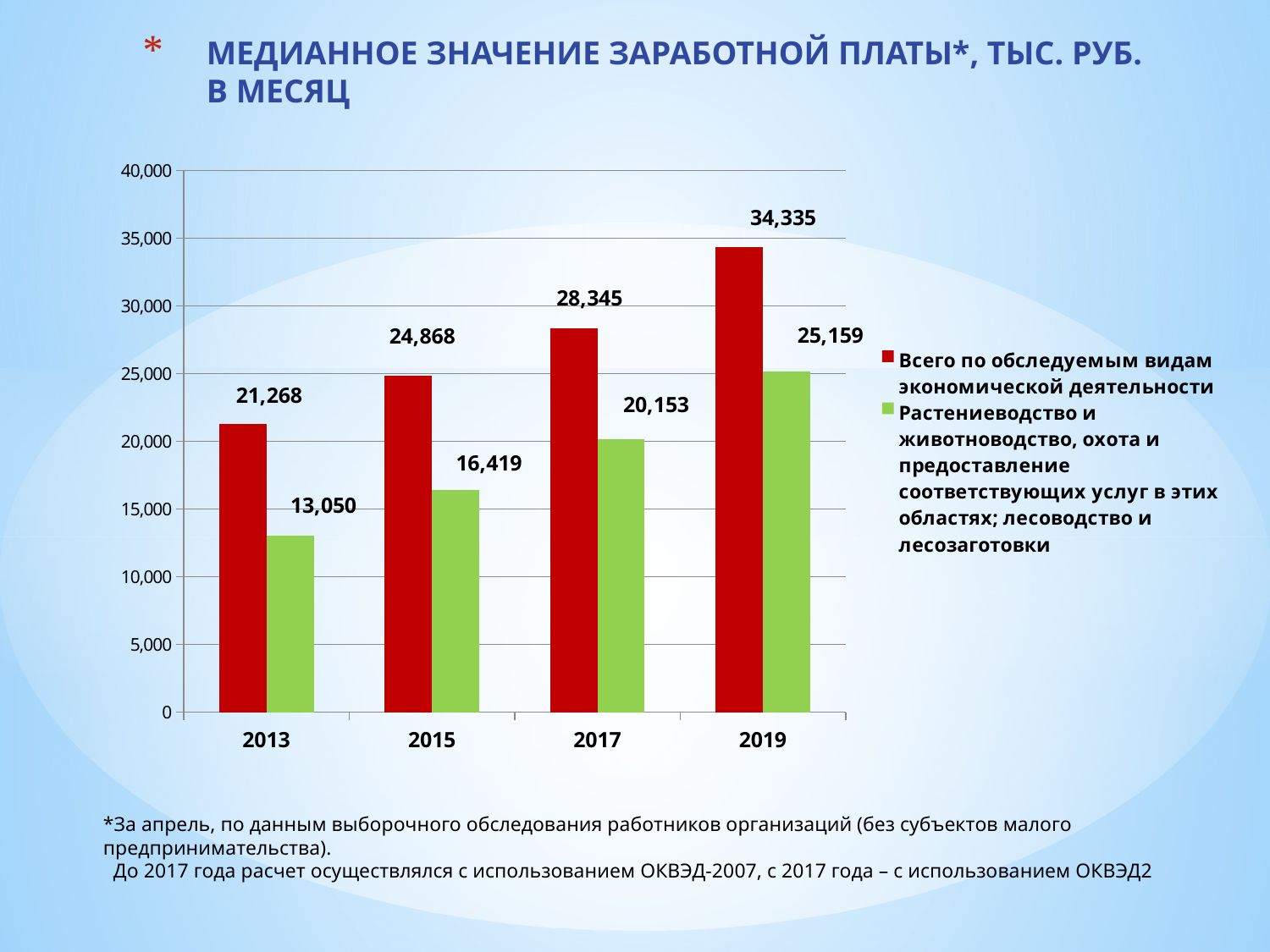
In which year is the value for the green series (Растениеводство и животноводство...) lowest? 2013 What is the value for "Всего по обследуемым видам экономической деятельности" in 2017? 28,345 In which year is the value for "Всего по обследуемым видам экономической деятельности" highest? 2019 What is the value for "Всего по обследуемым видам экономической деятельности" in 2013? 21,268 What is the difference between the two series in 2019? 9,176 What is the value for "Растениеводство и животноводство, охота и предоставление соответствующих услуг в этих областях; лесоводство и лесозаготовки" in 2019? 25,159 How many years are shown on the x axis? 4 What is the value for the green series (Растениеводство и животноводство...) in 2015? 16,419 Do the values for "Всего по обследуемым видам экономической деятельности" rise or fall from 2013 to 2019? Rise How many series does the legend list? 2 Which is larger in 2017: "Всего по обследуемым видам экономической деятельности" or "Растениеводство и животноводство..."? Всего по обследуемым видам экономической деятельности What kind of chart is shown on the slide? Bar chart